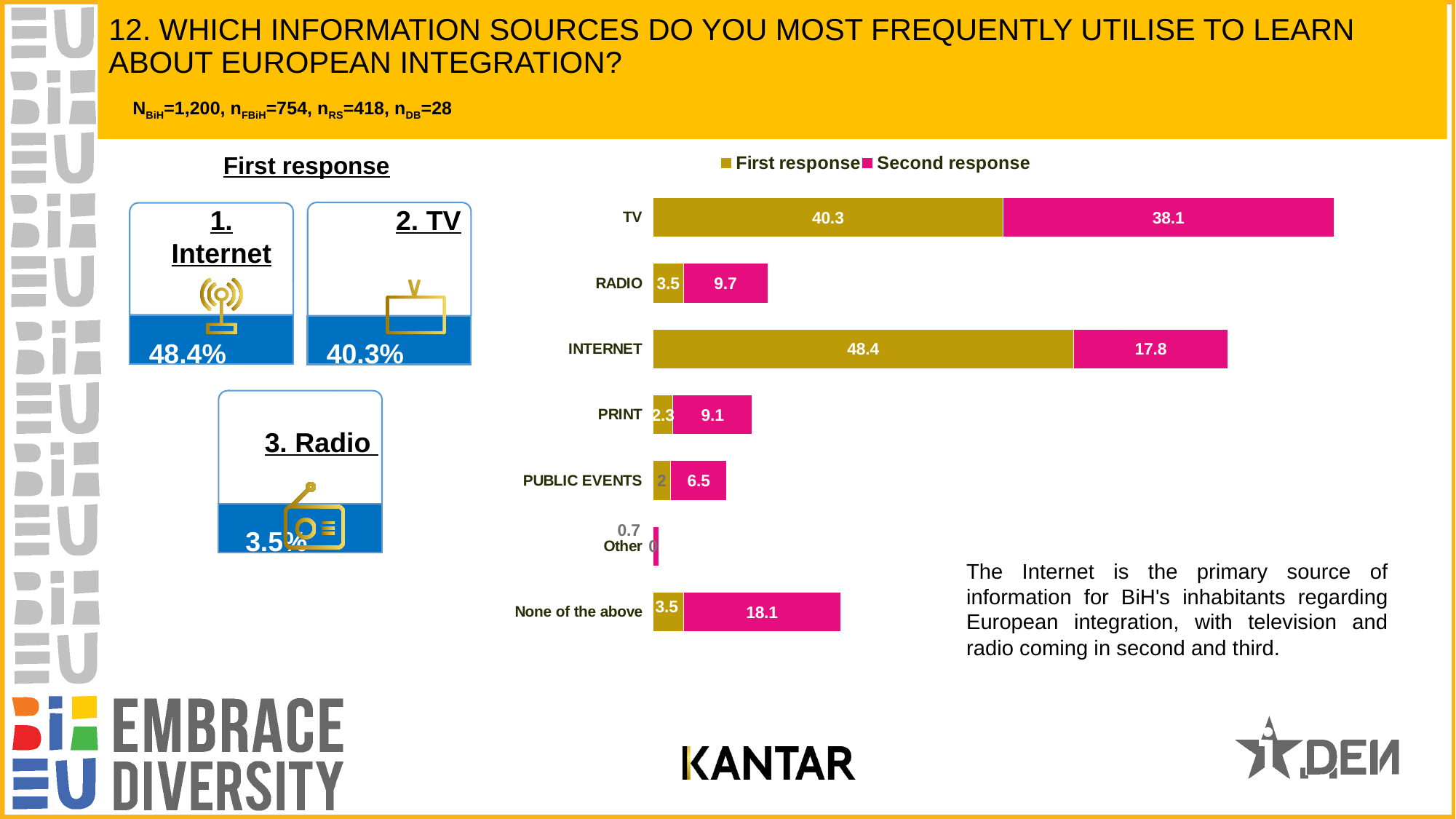
Which is larger, the Second response value for RADIO or for PRINT? RADIO What is the First response value for INTERNET? 48.4 What is the Second response value for TV? 38.1 What is the First response value for PRINT? 2.3 What is the difference between the First response values for INTERNET and TV? 8.1 What is the combined total of First response and Second response for TV? 78.4 How many series does the chart legend list? 2 What type of chart is used to show the information sources? Stacked bar chart Which category has the highest First response value? INTERNET How many categories are shown on the bar chart? 7 What is the Second response value for None of the above? 18.1 Which category has the highest Second response value? TV